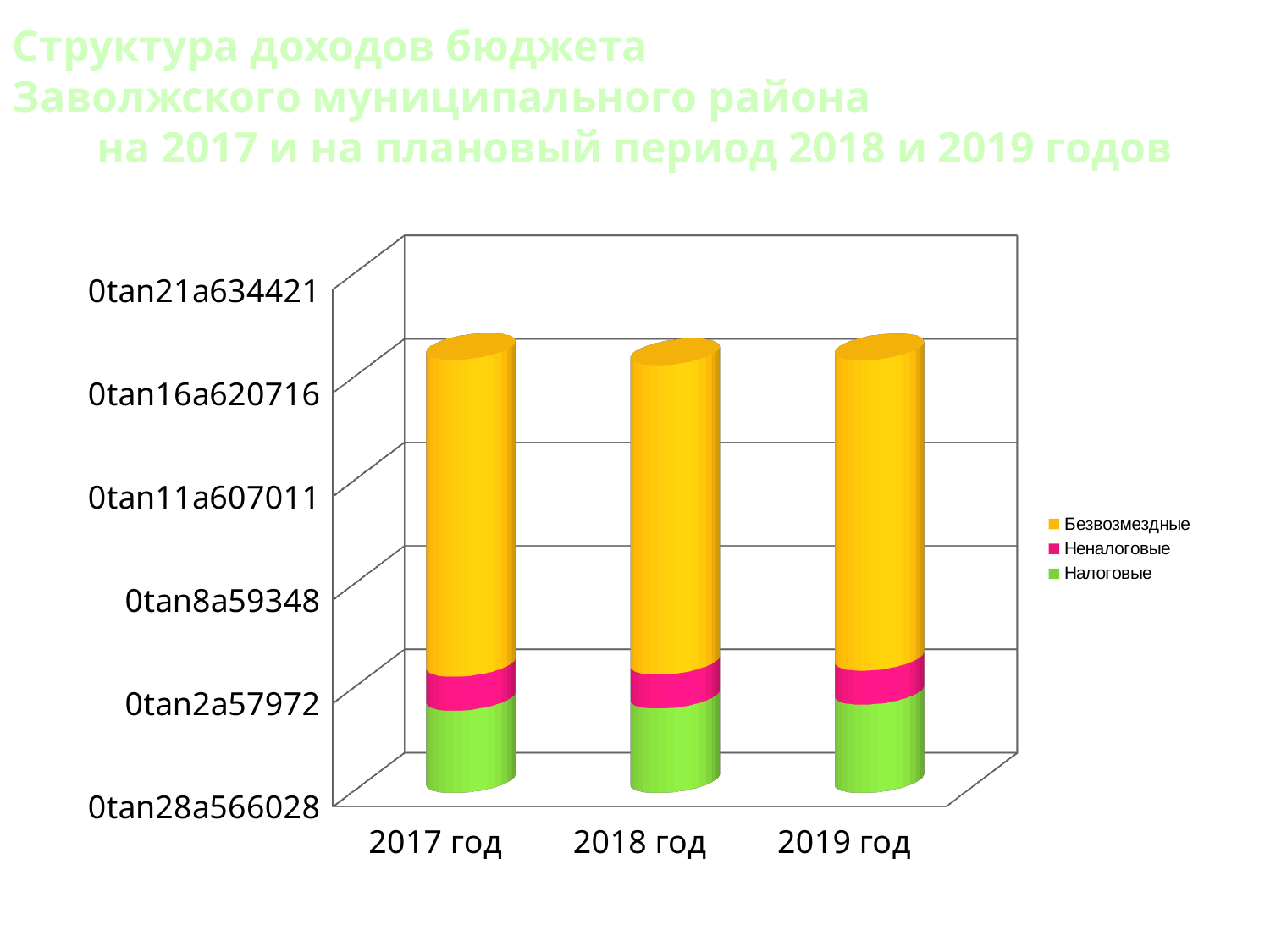
In the bar for 2019 год, which segment is larger: Налоговые or Неналоговые? Налоговые How many series does the chart's legend list? 3 What are the three categories on the x axis of the chart? 2017 год, 2018 год, 2019 год In the bar for 2017 год, which segment is larger: Безвозмездные or Налоговые? Безвозмездные How many categories are shown on the x axis of the chart? 3 Which series makes up the smallest segment of the bar for 2018 год? Неналоговые What kind of chart is shown on the slide? Stacked bar chart Which series makes up the largest segment of the bar for 2017 год? Безвозмездные What colour represents the Налоговые series in the chart? Green What are the series names listed in the chart's legend? Безвозмездные, Неналоговые, Налоговые